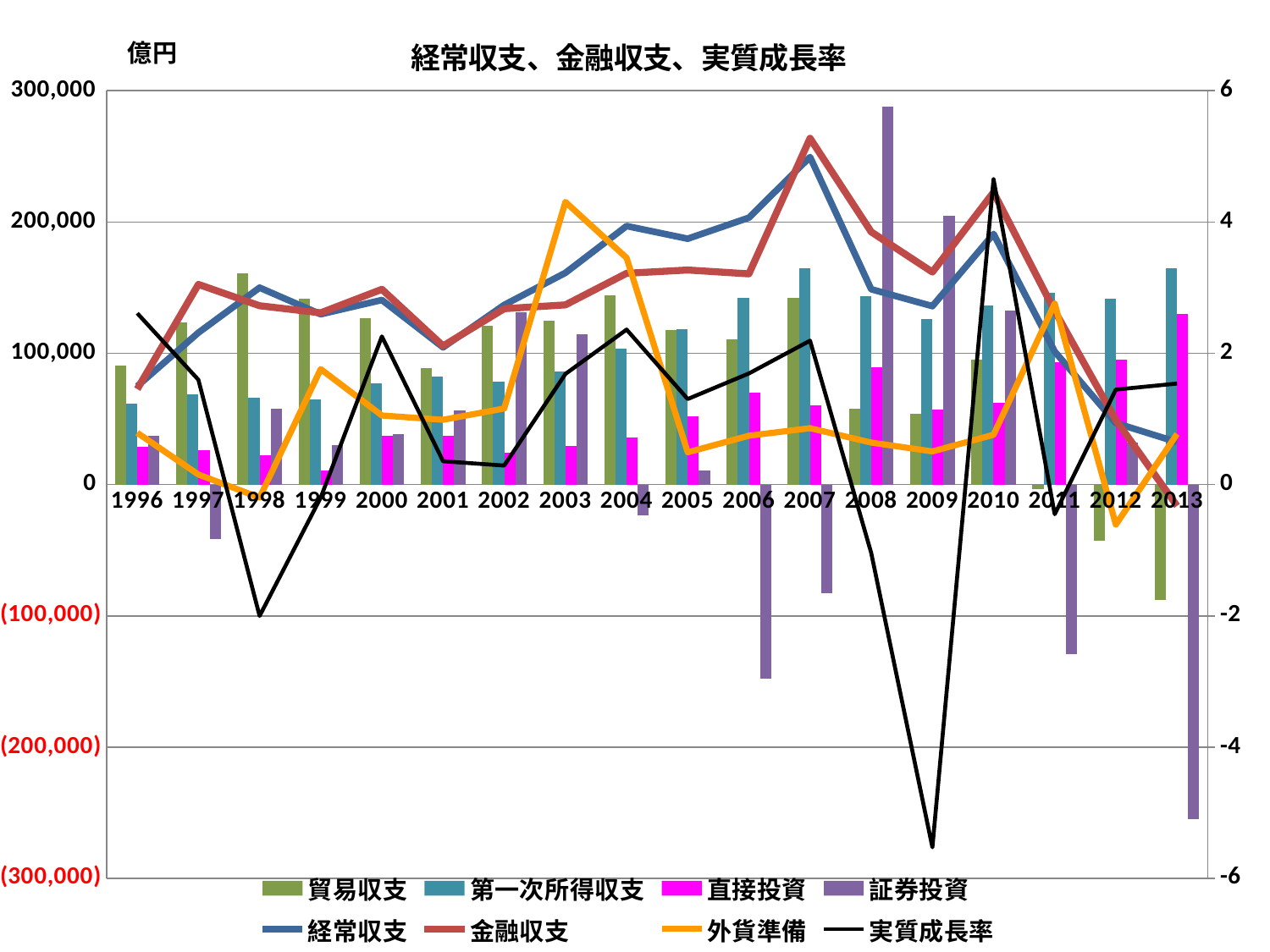
In which year does the 実質成長率 line reach its lowest point? 2009 Does the 経常収支 line rise or fall from 2010 to 2013? fall In which year is the 証券投資 bar highest? 2008 In 2013, which is larger, the 第一次所得収支 bar or the 貿易収支 bar? 第一次所得収支 How many years are shown on the x axis of the chart? 18 What kind of chart is shown on the slide? A combination bar and line chart In which year does the 金融収支 line reach its highest point? 2007 In which year does the 外貨準備 line reach its highest point? 2003 How many series does the legend list? 8 What is the title of the chart? 経常収支、金融収支、実質成長率 Is the 証券投資 value for 2008 greater or less than 200,000? greater Is the 実質成長率 value for 2009 greater or less than -4? less